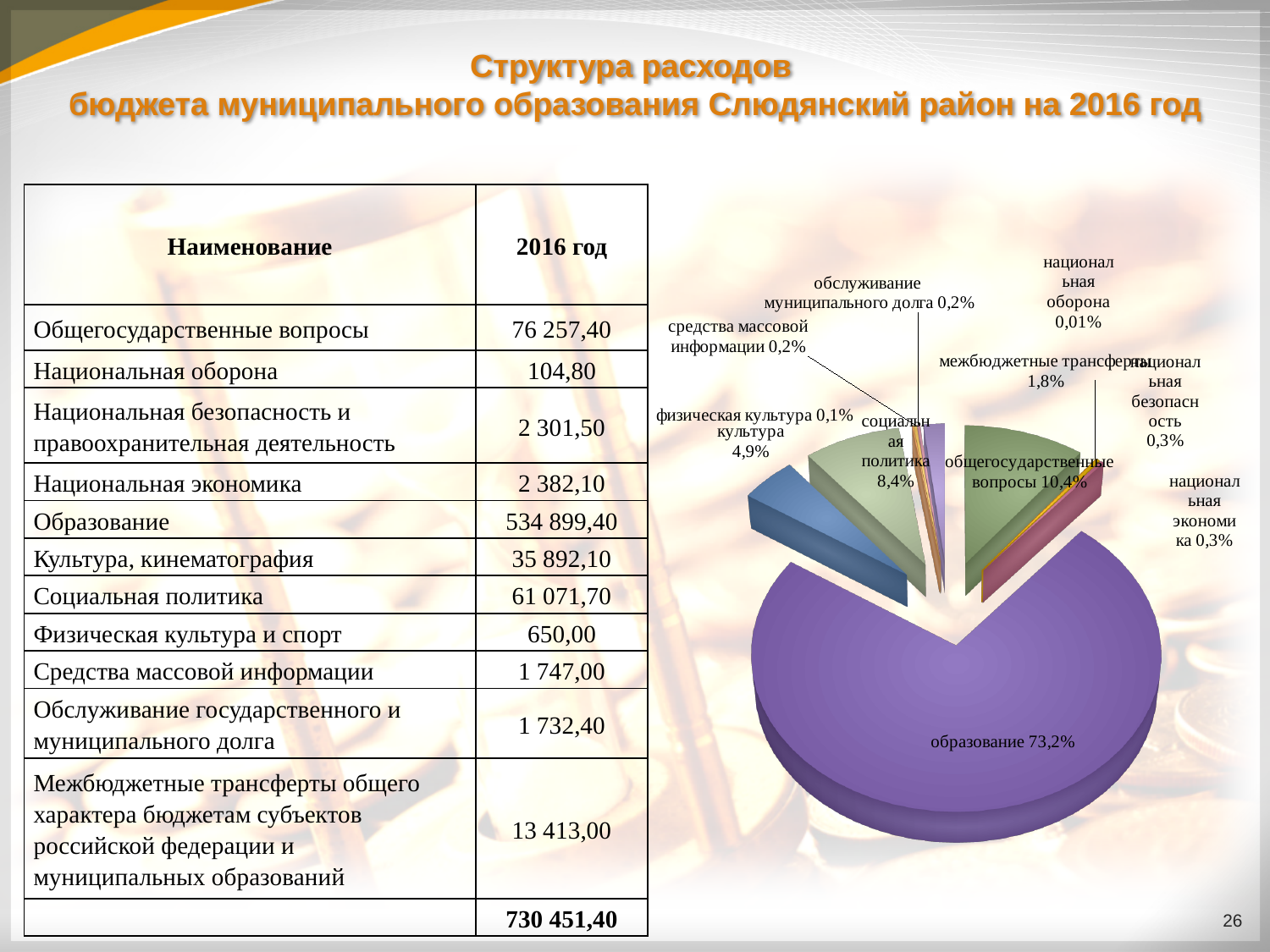
How many slices does the pie chart have? 11 Which slice of the pie is the smallest? национальная оборона What share of the pie does культура have? 4,9% What share of the pie does образование have? 73,2% What share of the pie does межбюджетные трансферты have? 1,8% Which is larger in the pie chart, социальная политика or культура? социальная политика Which slice of the pie is the largest? образование What share of the pie does общегосударственные вопросы have? 10,4% What share of the pie does национальная оборона have? 0,01% What share of the pie does социальная политика have? 8,4% What kind of chart is shown on the slide? pie chart What is the difference in share between образование and общегосударственные вопросы? 62,8%